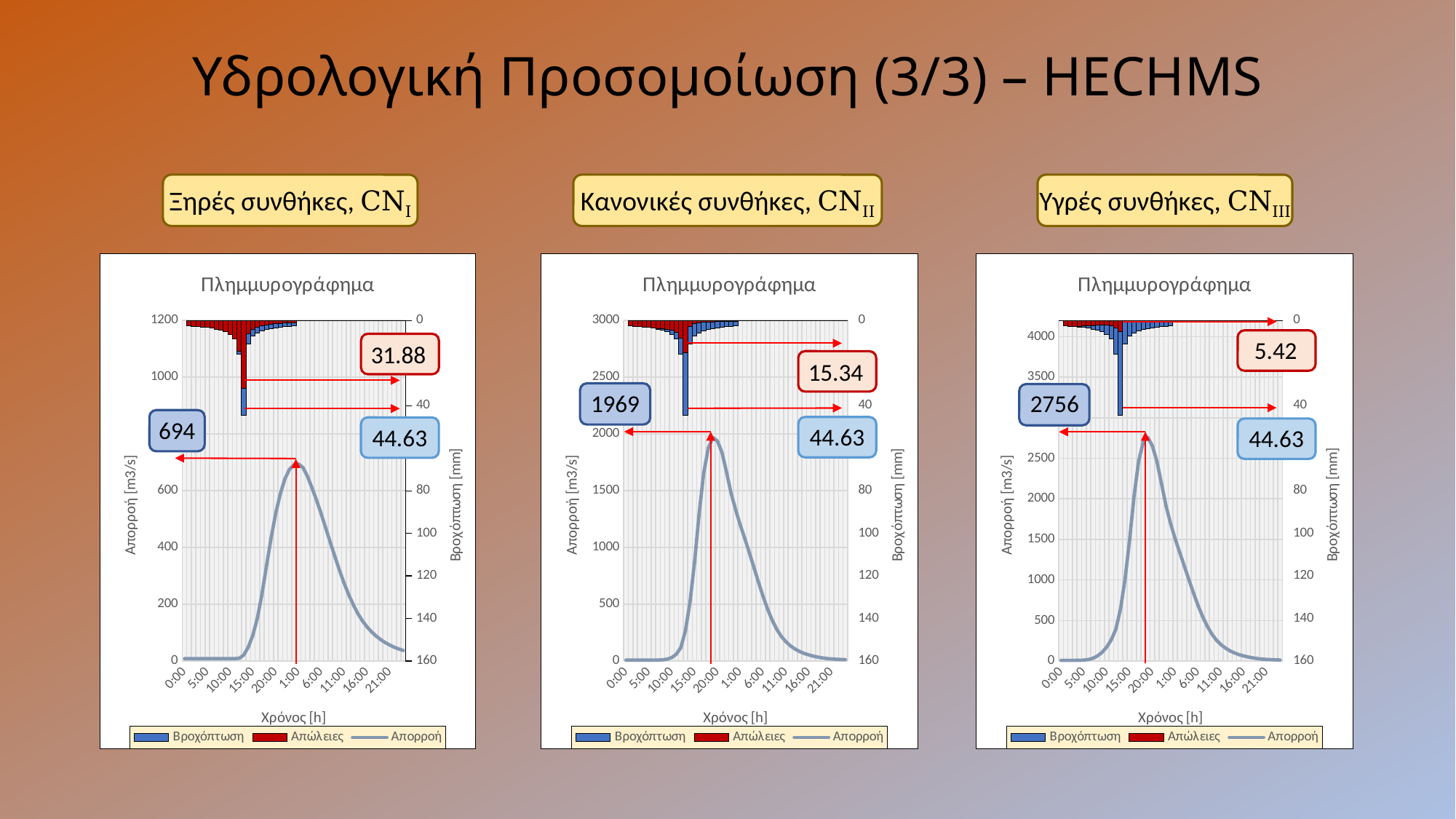
On the right chart (Υγρές συνθήκες, CN III), what is the annotated peak runoff value? 2756 How many series does the legend of the left chart list? 3 On the middle chart (Κανονικές συνθήκες, CN II), what is the annotated peak runoff value? 1969 On the right chart (Υγρές συνθήκες, CN III), what is the annotated losses value shown in the red box? 5.42 What is the difference between the annotated peak runoff of the right chart (2756) and the left chart (694)? 2062 On the left chart (Ξηρές συνθήκες, CN I), what is the annotated peak runoff value? 694 Is the annotated peak runoff on the middle chart (Κανονικές συνθήκες, CN II) larger or smaller than that on the left chart (Ξηρές συνθήκες, CN I)? larger On the middle chart (Κανονικές συνθήκες, CN II), what is the annotated losses value shown in the red box? 15.34 On the middle chart (Κανονικές συνθήκες, CN II), what is the annotated rainfall value shown in the light blue box? 44.63 Across the three charts, which condition has the highest annotated peak runoff? Υγρές συνθήκες, CN III On the left chart (Ξηρές συνθήκες, CN I), what is the annotated losses value shown in the red box? 31.88 Across the three charts, which condition has the lowest annotated losses value? Υγρές συνθήκες, CN III